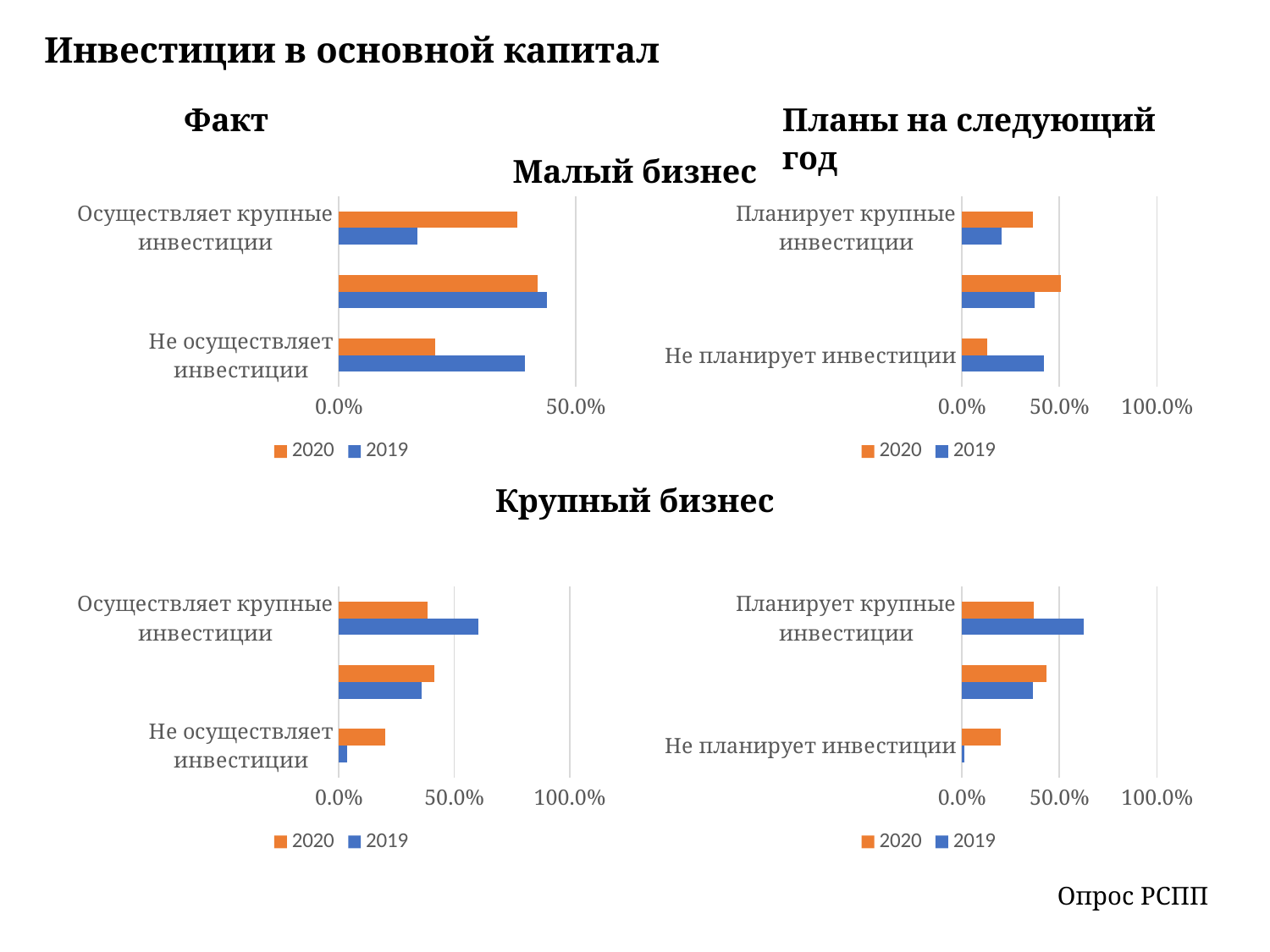
In the 'Малый бизнес' Планы chart (top-right), is the 2020 value for 'Не планирует инвестиции' greater or less than 50.0%? less In the 'Малый бизнес' Факт chart (top-left), which year has the larger value for 'Осуществляет крупные инвестиции', 2020 or 2019? 2020 How many categories are plotted in the 'Крупный бизнес' Факт chart (bottom-left)? 3 In the 'Крупный бизнес' Факт chart (bottom-left), which category has the lowest 2019 value? Не осуществляет инвестиции In the 'Малый бизнес' Факт chart (top-left), which year has the larger value for 'Не осуществляет инвестиции', 2020 or 2019? 2019 In the 'Крупный бизнес' Планы chart (bottom-right), is the 2019 value for 'Планирует крупные инвестиции' greater or less than 50.0%? greater In the 'Крупный бизнес' Факт chart (bottom-left), is the 2019 value for 'Осуществляет крупные инвестиции' greater or less than 50.0%? greater In the 'Крупный бизнес' Факт chart (bottom-left), which colour represents the 2020 series? orange In the 'Крупный бизнес' Планы chart (bottom-right), which year has the larger value for 'Не планирует инвестиции', 2020 or 2019? 2020 In the 'Малый бизнес' Планы chart (top-right), which category has the highest 2019 value? Не планирует инвестиции What kind of chart is the 'Малый бизнес' Факт chart (top-left)? bar chart How many series does the legend of the 'Крупный бизнес' Планы chart (bottom-right) list? 2